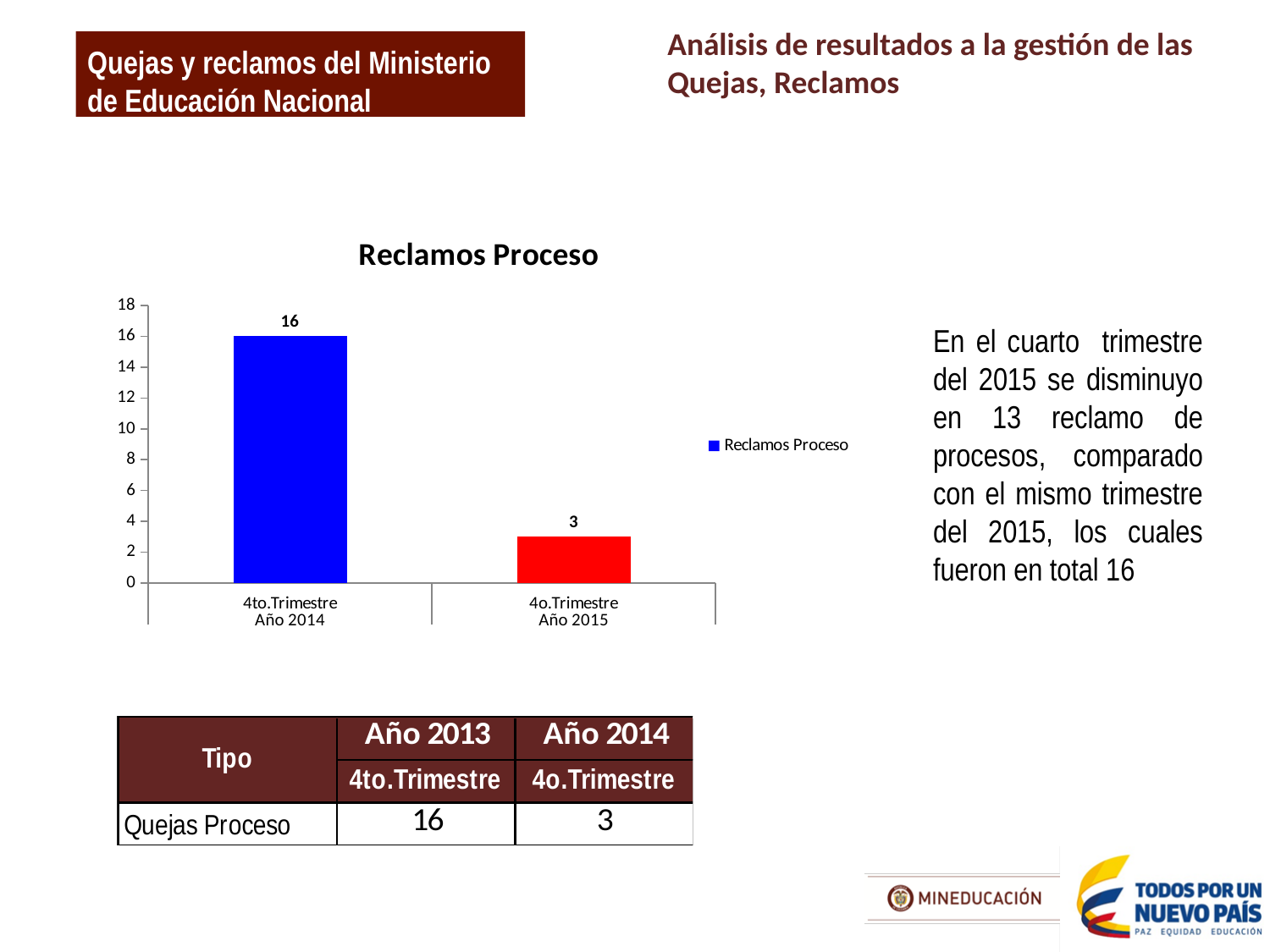
What kind of chart is the Reclamos Proceso chart? bar chart Do the values rise or fall from 4to.Trimestre Año 2014 to 4o.Trimestre Año 2015 in the Reclamos Proceso chart? fall How many series does the legend of the Reclamos Proceso chart list? 1 What is the difference between the values for 4to.Trimestre Año 2014 and 4o.Trimestre Año 2015 in the Reclamos Proceso chart? 13 Which is larger in the Reclamos Proceso chart: the value for 4to.Trimestre Año 2014 or for 4o.Trimestre Año 2015? 4to.Trimestre Año 2014 Is the value for 4to.Trimestre Año 2014 greater or less than 10? greater Is the value for 4o.Trimestre Año 2015 greater or less than 4? less Which category has the highest value in the Reclamos Proceso chart? 4to.Trimestre Año 2014 Which category has the lowest value in the Reclamos Proceso chart? 4o.Trimestre Año 2015 What is the value for 4to.Trimestre Año 2014 in the Reclamos Proceso chart? 16 What is the value for 4o.Trimestre Año 2015 in the Reclamos Proceso chart? 3 How many categories are shown on the x axis of the Reclamos Proceso chart? 2